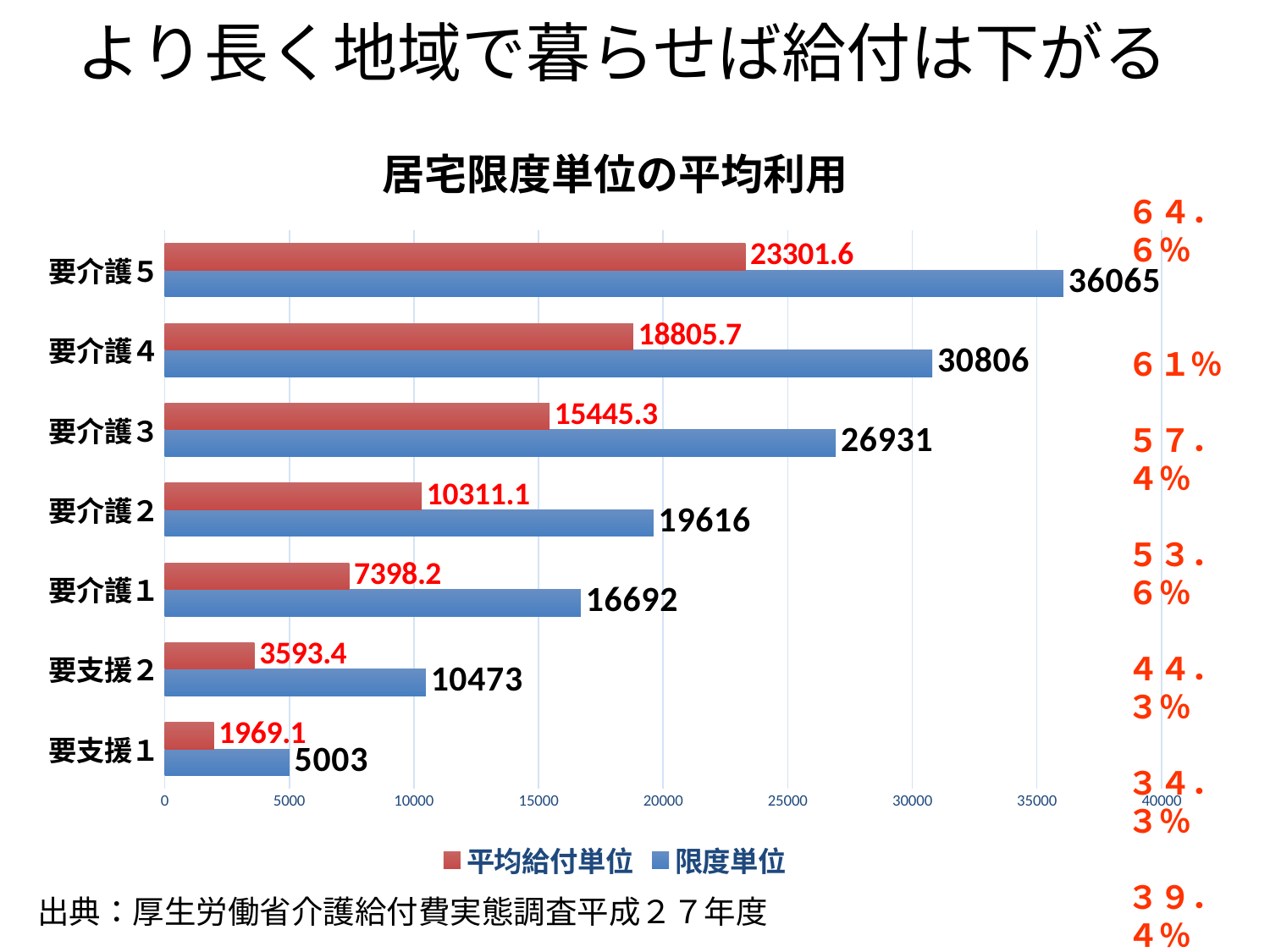
Which is larger: the 限度単位 value for 要支援2 or the 平均給付単位 value for 要介護2? 要支援2 限度単位 (10473) What is the 平均給付単位 value for 要介護3? 15445.3 Is the 平均給付単位 value for 要介護1 greater or less than 10000? less What is the 限度単位 value for 要介護5? 36065 Which category has the lowest 平均給付単位 value? 要支援1 How many categories are shown on the chart? 7 What is the 平均給付単位 value for 要支援1? 1969.1 What is the difference between the 限度単位 and 平均給付単位 values for 要介護4? 12000.3 How many series does the legend list? 2 What type of chart is shown on the slide? bar chart Which category has the highest 限度単位 value? 要介護5 What is the 限度単位 value for 要介護2? 19616